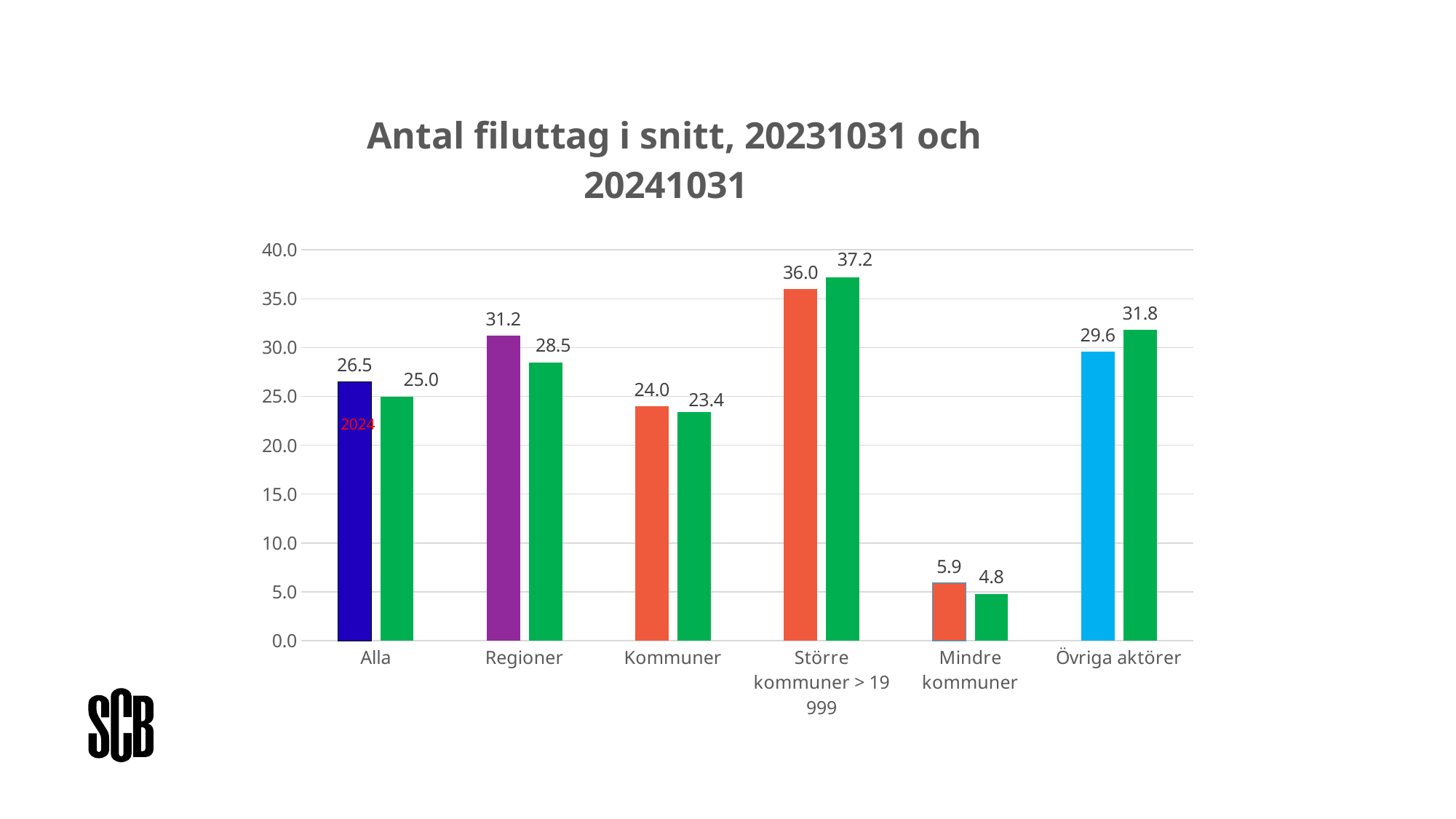
What is the value of the green (right) bar for Övriga aktörer? 31.8 Which category has the lowest left bar? Mindre kommuner Which category has the highest green (right) bar? Större kommuner > 19 999 For Övriga aktörer, which bar is larger, the left bar or the green (right) bar? The green (right) bar (31.8) What is the value of the left bar for Regioner? 31.2 How many categories are shown on the x axis? 6 For Alla, which bar is larger, the left bar or the green (right) bar? The left bar (26.5) What is the value of the left bar for Mindre kommuner? 5.9 Is the value of the green (right) bar for Kommuner greater or less than 25.0? less For Större kommuner > 19 999, how much larger is the green (right) bar than the left bar? 1.2 For Regioner, what is the difference between the left bar (31.2) and the green bar (28.5)? 2.7 What type of chart is shown on the slide? Bar chart